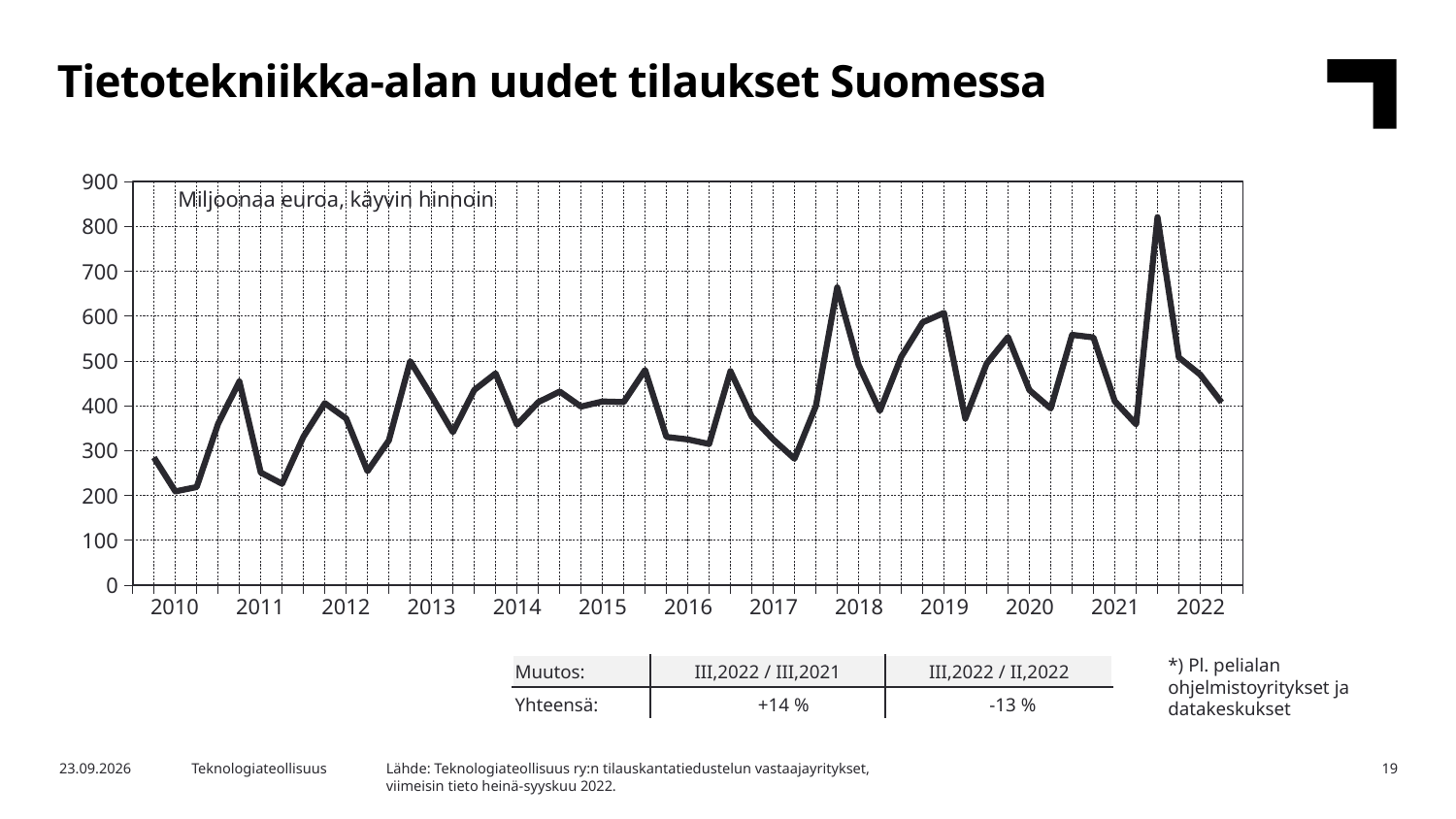
In which year does the line reach its highest point? 2021 Is the lowest value in 2010 greater or less than 300? less How many years are labelled on the x axis? 13 What is the title of the chart on the slide? Tietotekniikka-alan uudet tilaukset Suomessa In which year does the line reach its lowest point? 2010 Is the highest peak of the line greater or less than 800? greater What unit label is printed inside the chart area? Miljoonaa euroa, käyvin hinnoin Which is higher, the peak in 2021 or the peak in 2018? 2021 From the peak in 2021 to the last point in 2022, does the line rise or fall? fall What kind of chart is shown on the slide? line chart Is the peak value in 2018 greater or less than 600? greater